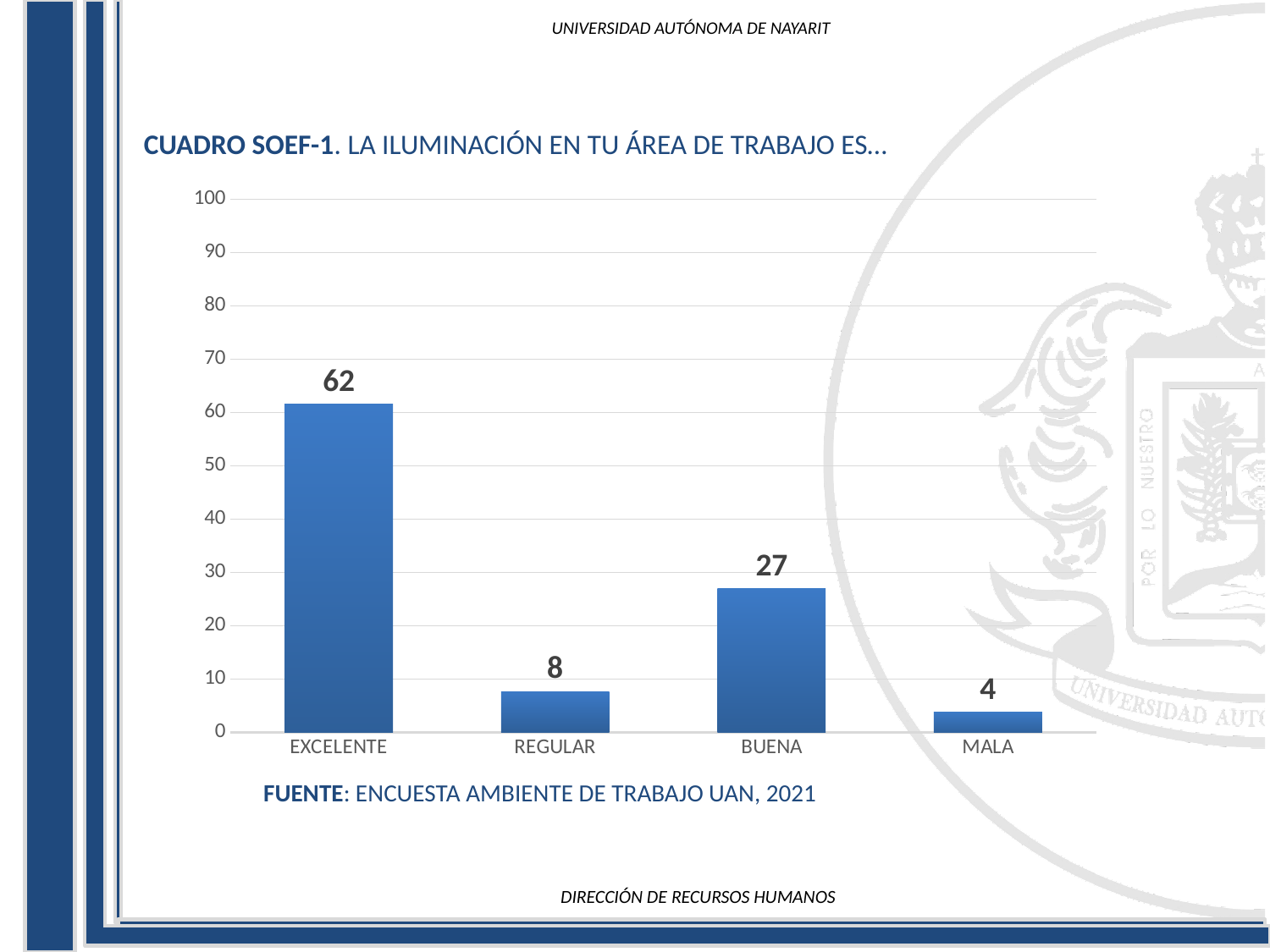
What is the difference between the values for REGULAR and MALA? 4 How many categories are shown on the x axis? 4 What kind of chart is shown on the slide? bar chart What is the difference between the values for EXCELENTE and BUENA? 35 What is the value for MALA? 4 Which is larger, the value for BUENA or the value for REGULAR? BUENA What is the value for BUENA? 27 What is the value for REGULAR? 8 What is the value for EXCELENTE? 62 Which category has the lowest value? MALA What source is cited below the chart? ENCUESTA AMBIENTE DE TRABAJO UAN, 2021 Which category has the highest value? EXCELENTE